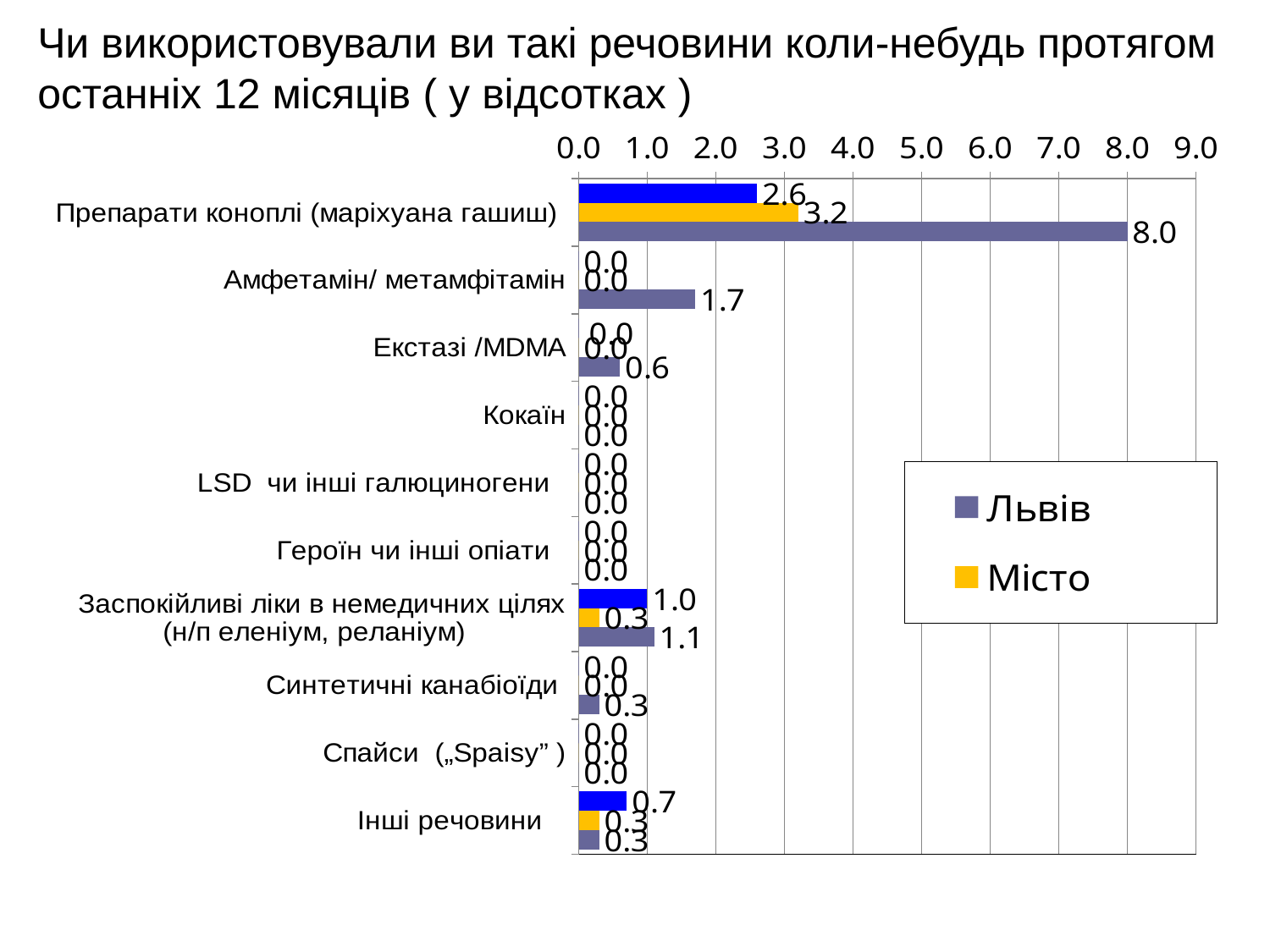
What is the difference between the Львів and Місто values for Препарати коноплі (маріхуана гашиш)? 4.8 What is the value for Місто for Препарати коноплі (маріхуана гашиш)? 3.2 What is the value for Львів for Екстазі /MDMA? 0.6 How many categories are shown on the chart? 10 What is the value for Львів for Препарати коноплі (маріхуана гашиш)? 8.0 What is the value for Львів for Амфетамін/ метамфітамін? 1.7 What is the value for Місто for Заспокійливі ліки в немедичних цілях (н/п еленіум, реланіум)? 0.3 Which category has the highest value for Львів? Препарати коноплі (маріхуана гашиш) For Заспокійливі ліки в немедичних цілях, which is larger: the Львів value or the Місто value? Львів What colour represents the Місто series in the legend? yellow Is the Львів value for Препарати коноплі (маріхуана гашиш) greater or less than 7.0? greater What kind of chart is shown on the slide? bar chart